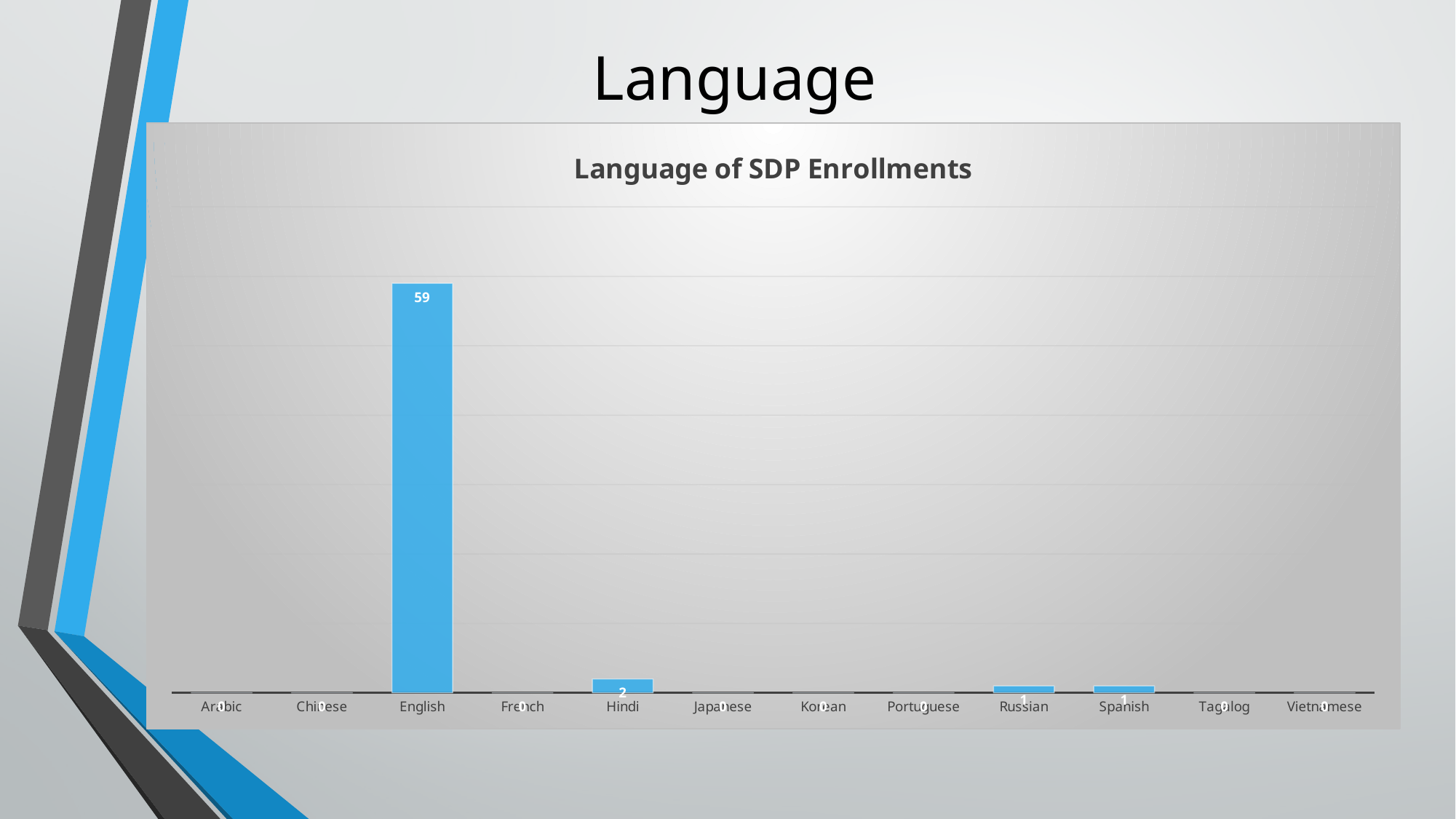
How many language categories are shown on the x axis? 12 What is the value for Arabic? 0 What is the value for Russian? 1 What kind of chart is shown on the slide? bar chart What is the value for Spanish? 1 What is the difference between the values for Hindi and Russian? 1 Which is larger, the value for Hindi or the value for Spanish? Hindi What is the title of the chart? Language of SDP Enrollments What is the value for English? 59 What is the value for Hindi? 2 Which language has the highest number of enrollments? English What is the difference between the values for English and Hindi? 57